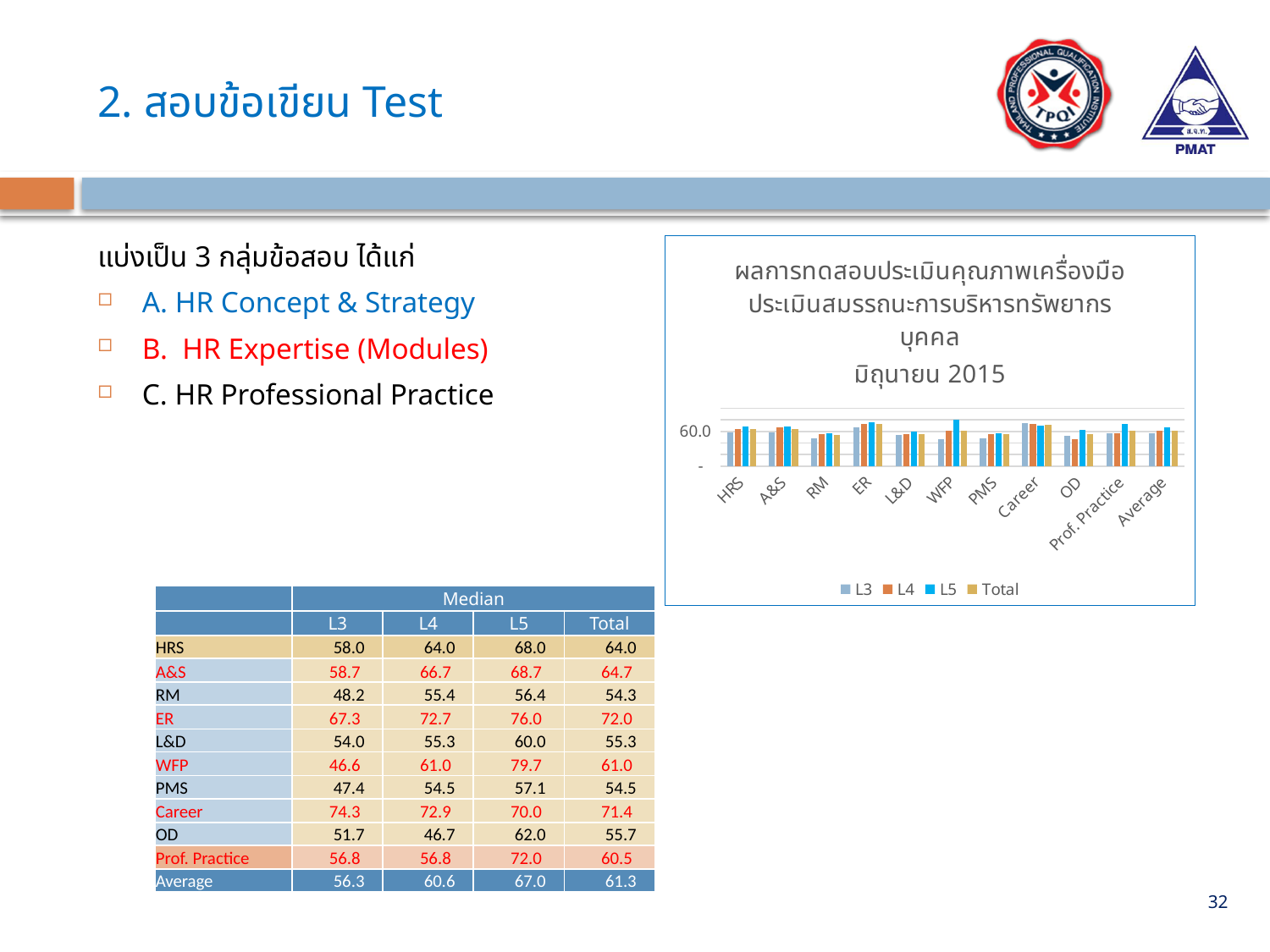
Which category has the highest L5 bar in the chart? WFP How many categories are shown along the x axis of the chart? 11 Which category has the lowest L4 bar in the chart? OD According to the table, what is the Total median for ER? 72.0 Which series are listed in the chart legend? L3, L4, L5, Total How many series does the chart legend list? 4 What kind of chart is shown on the slide? bar chart According to the table, what is the difference between the L5 and L3 medians for WFP? 33.1 Is the L5 value for WFP greater or less than 60.0? greater Is the L3 value for RM greater or less than 60.0? less Is the L5 value for ER greater or less than 60.0? greater Which category has the highest L3 bar in the chart? Career